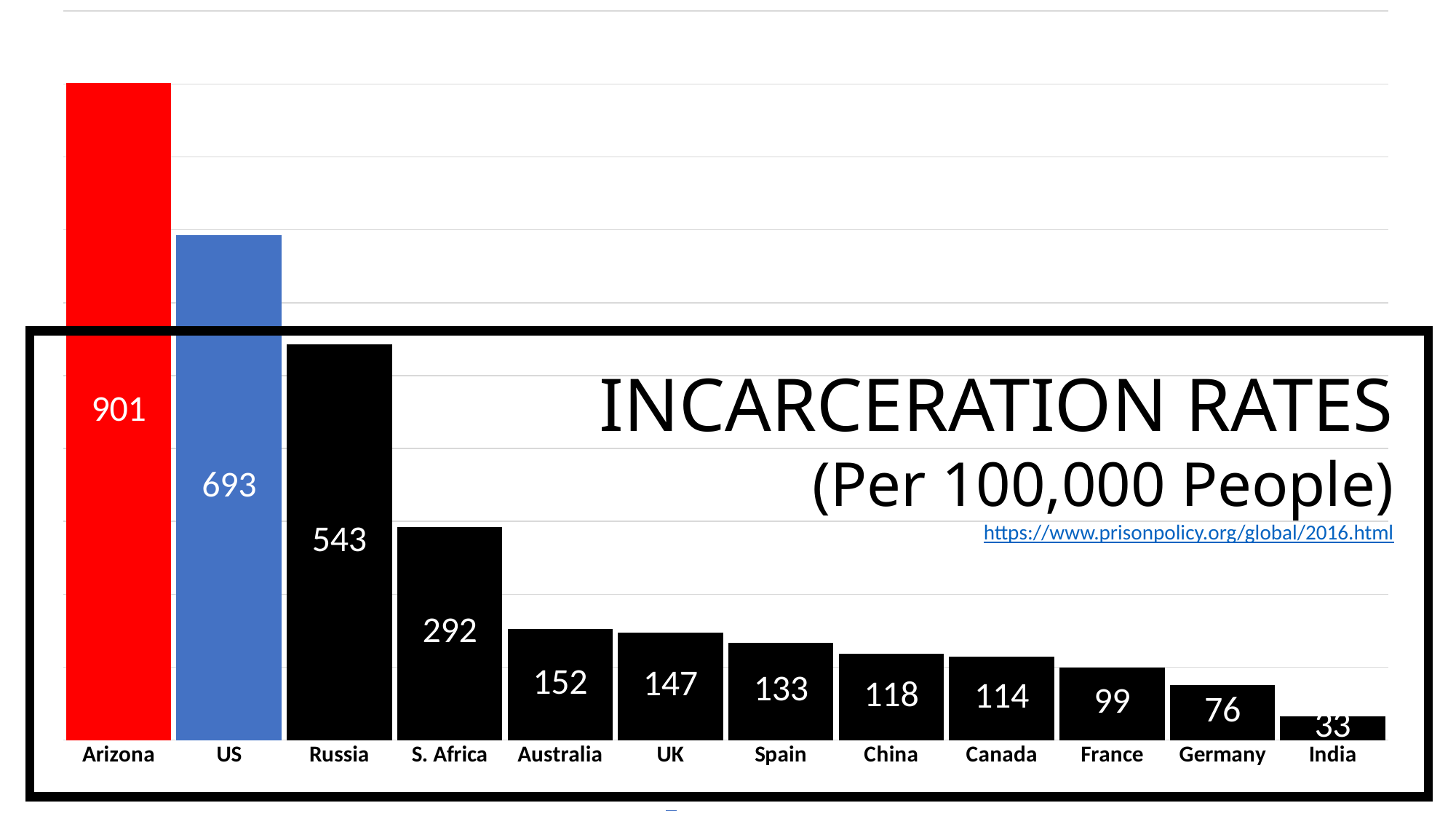
What kind of chart is shown on the slide? Bar chart Which category has the highest incarceration rate? Arizona What is the incarceration rate for Arizona? 901 What is the incarceration rate for Russia? 543 What is the difference between the incarceration rates of Russia and S. Africa? 251 Do the values rise or fall from left to right along the x axis? Fall Which has a higher incarceration rate, Australia or Spain? Australia What is the difference between the incarceration rates of Arizona and the US? 208 What is the title of the chart? INCARCERATION RATES (Per 100,000 People) Which category has the lowest incarceration rate? India What is the incarceration rate for Germany? 76 How many categories are shown in the chart? 12